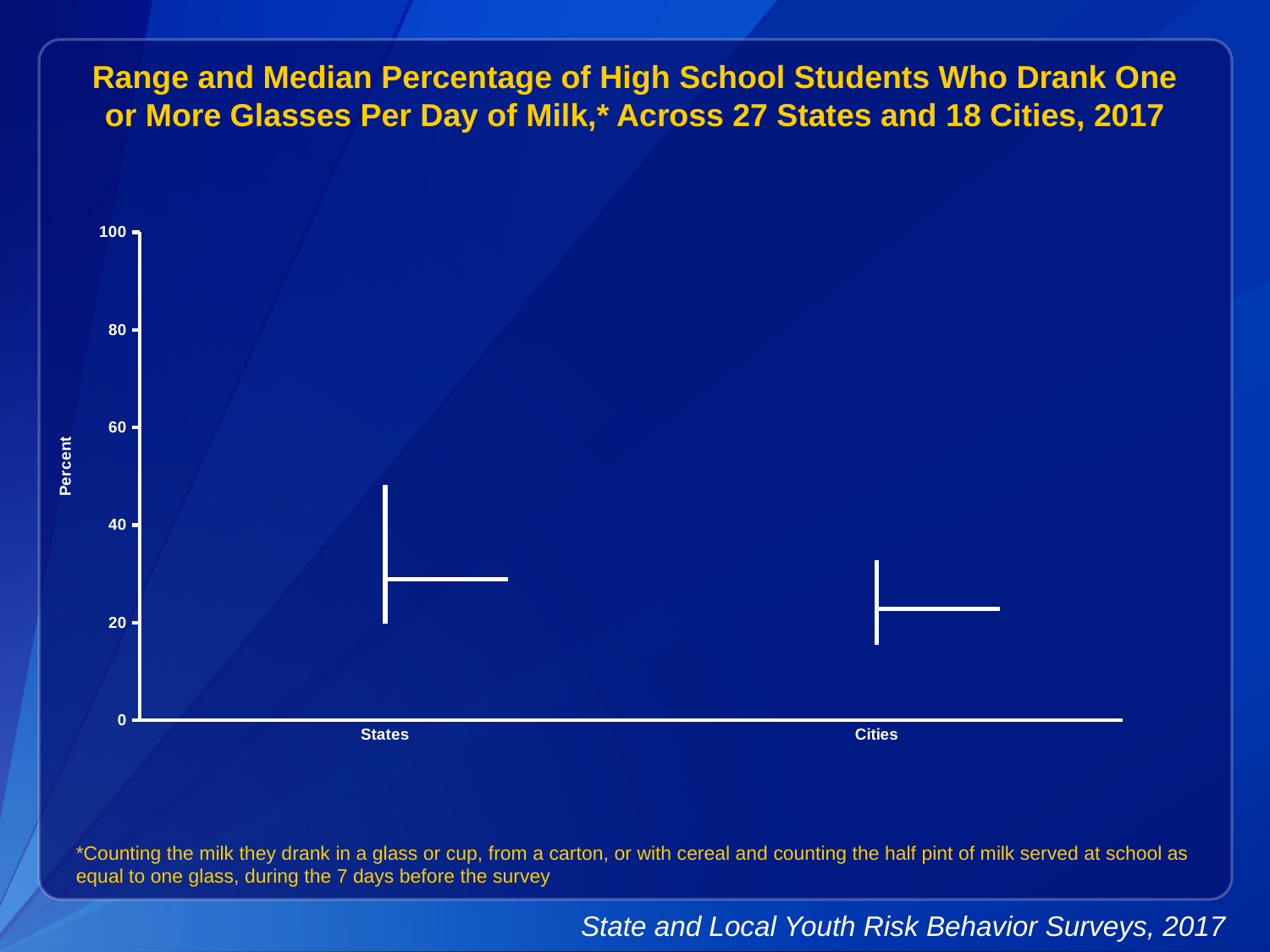
Is the median value for States greater or less than 20? greater Is the bottom of the range for Cities greater or less than 20? less Is the median value for Cities greater or less than 40? less Which category has the highest median value? States How many categories are shown on the x axis? 2 Which has the higher median percentage, States or Cities? States What is the highest value shown on the y axis? 100 What is the label of the y axis? Percent